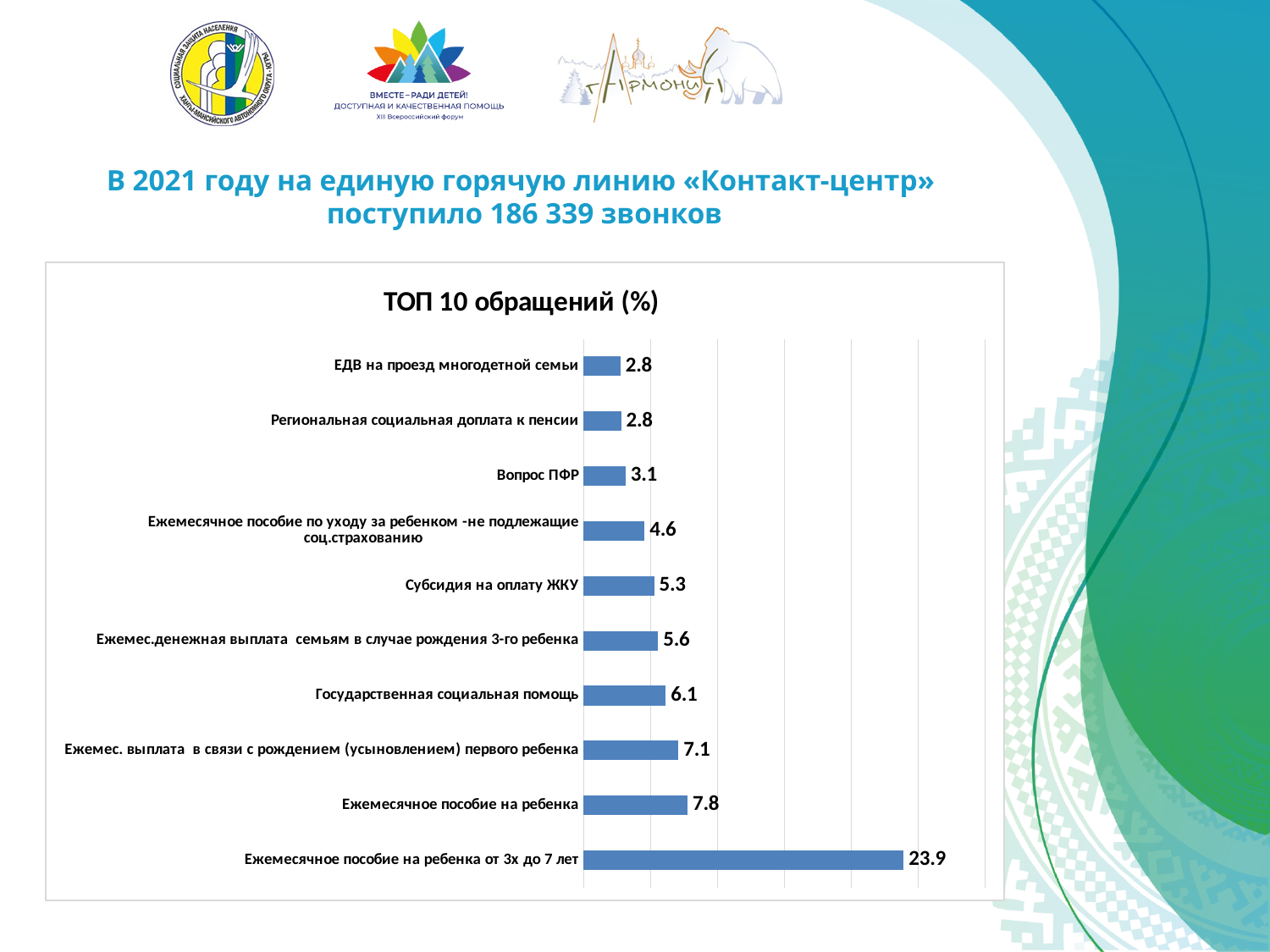
Which is larger: «Государственная социальная помощь» or «Субсидия на оплату ЖКУ»? Государственная социальная помощь What is the value for «Субсидия на оплату ЖКУ»? 5.3 What is the value for «Ежемесячное пособие на ребенка от 3х до 7 лет»? 23.9 What kind of chart is shown on the slide? Bar chart What is the title of the chart? ТОП 10 обращений (%) What is the difference between «Ежемес. выплата в связи с рождением (усыновлением) первого ребенка» and «Ежемес.денежная выплата семьям в случае рождения 3-го ребенка»? 1.5 What is the value for «Государственная социальная помощь»? 6.1 How many categories are shown in the chart? 10 What is the value for «Вопрос ПФР»? 3.1 Which category has the highest value? Ежемесячное пособие на ребенка от 3х до 7 лет What is the difference between «Ежемесячное пособие на ребенка от 3х до 7 лет» and «Ежемесячное пособие на ребенка»? 16.1 Which is larger: «Вопрос ПФР» or «Ежемесячное пособие по уходу за ребенком -не подлежащие соц.страхованию»? Ежемесячное пособие по уходу за ребенком -не подлежащие соц.страхованию